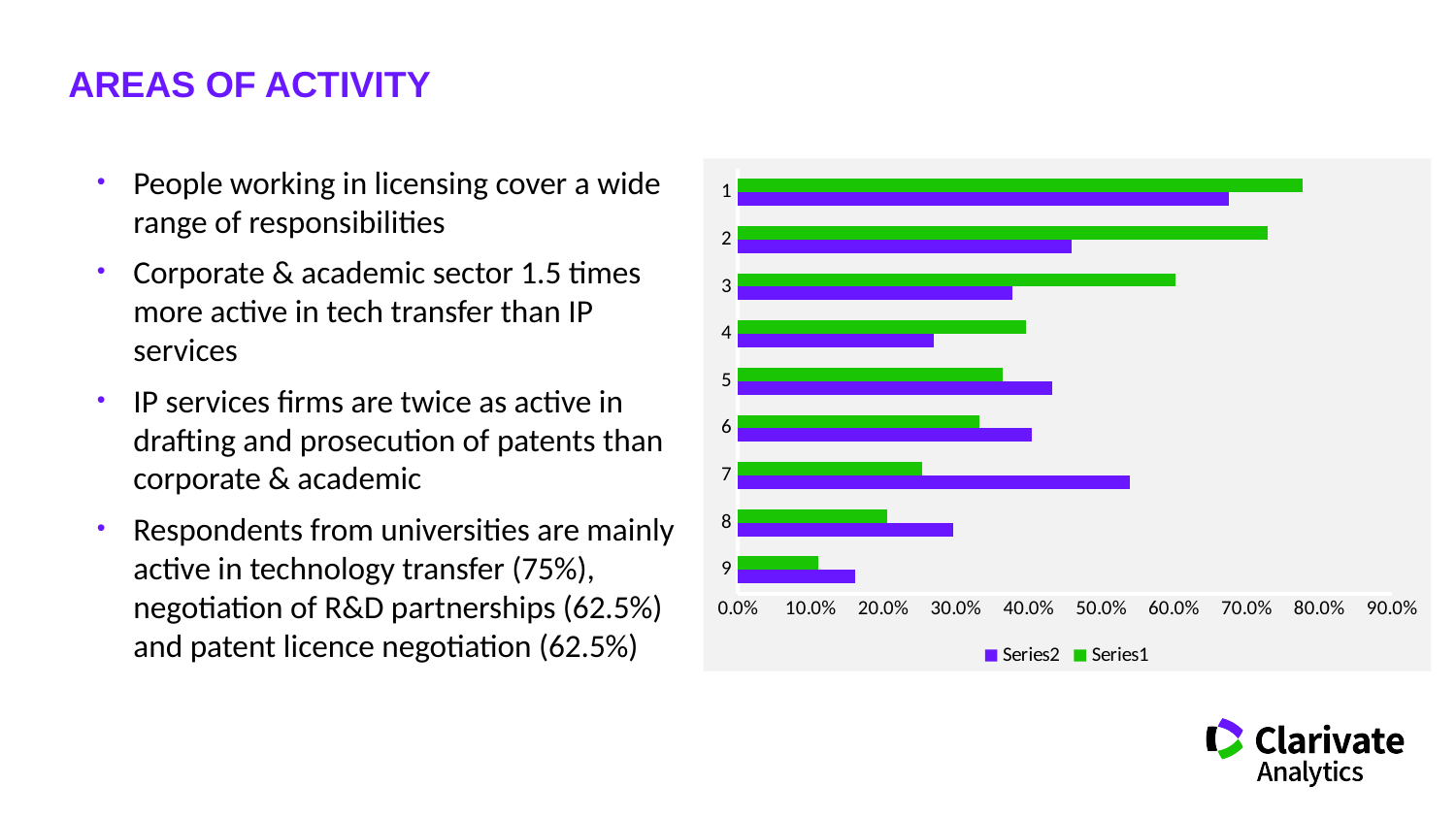
Is the Series1 value for category 9 greater or less than 20.0%? less Which category has the lowest Series1 value? 9 Which category has the lowest Series2 value? 9 How many categories are plotted on the chart? 9 How many series does the legend list? 2 What kind of chart is shown on the slide? bar chart Is the Series2 value for category 7 greater or less than 50.0%? greater Do the Series1 values rise or fall going from category 1 down to category 9? fall Which category has the highest Series1 value? 1 Is the Series1 value for category 2 greater or less than 70.0%? greater For category 7, which series has the larger value, Series1 or Series2? Series2 Which category has the highest Series2 value? 1